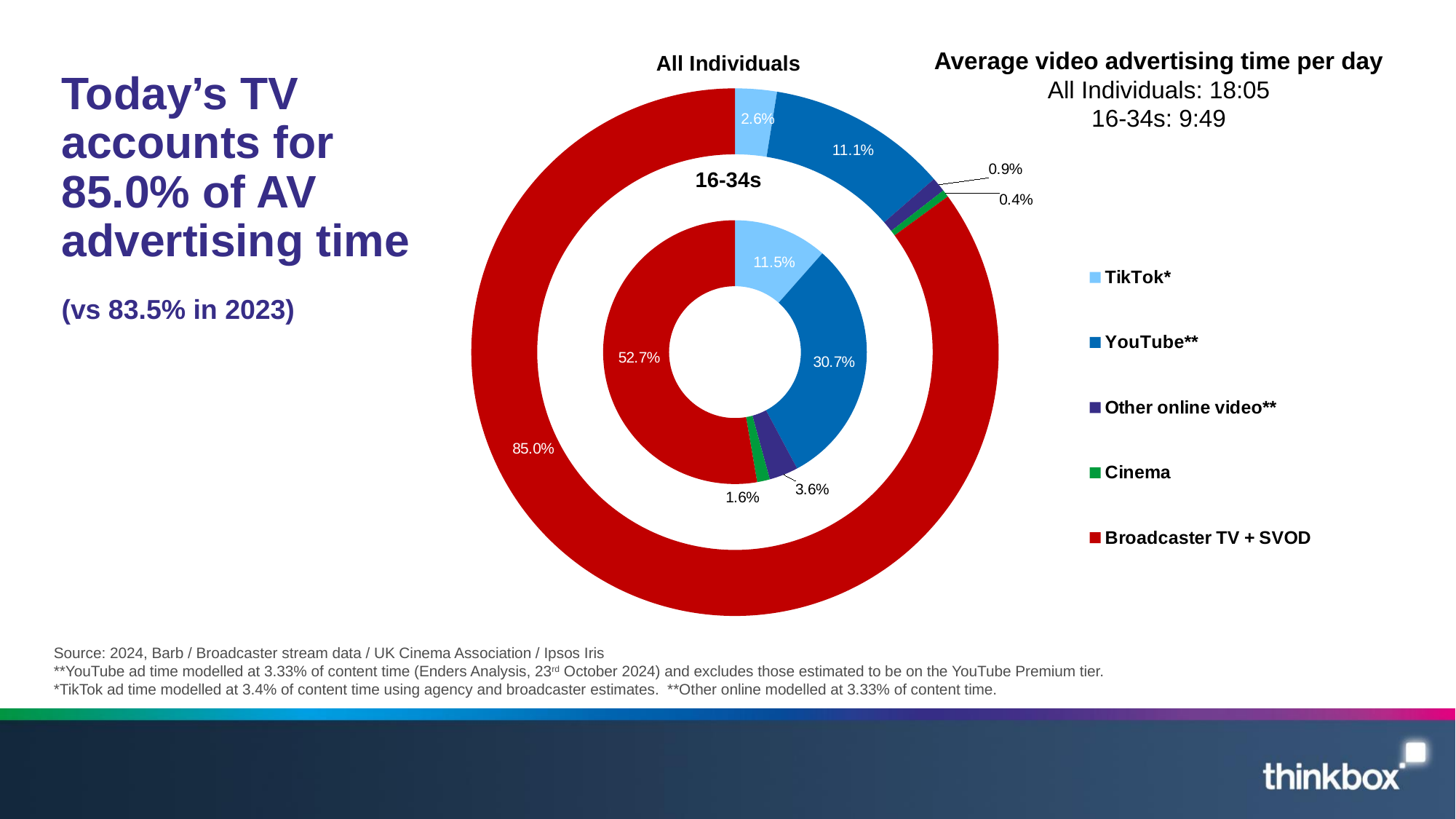
What colour represents Broadcaster TV + SVOD in the chart? Red Which category has the smallest share in the All Individuals ring? Cinema What share of AV advertising time does Broadcaster TV + SVOD account for in the All Individuals ring? 85.0% What kind of chart is shown on the slide? Doughnut chart What share does YouTube** have in the 16-34s ring? 30.7% How many categories does the legend list? 5 In the 16-34s ring, which is larger: the TikTok* share or the Other online video** share? TikTok* Which category has the largest share in the 16-34s ring? Broadcaster TV + SVOD How much larger is the YouTube** share for 16-34s than for All Individuals? 19.6% What is the TikTok* share in the All Individuals ring? 2.6% What is the Cinema share in the 16-34s ring? 1.6% What is the difference between the Broadcaster TV + SVOD share for All Individuals and for 16-34s? 32.3%